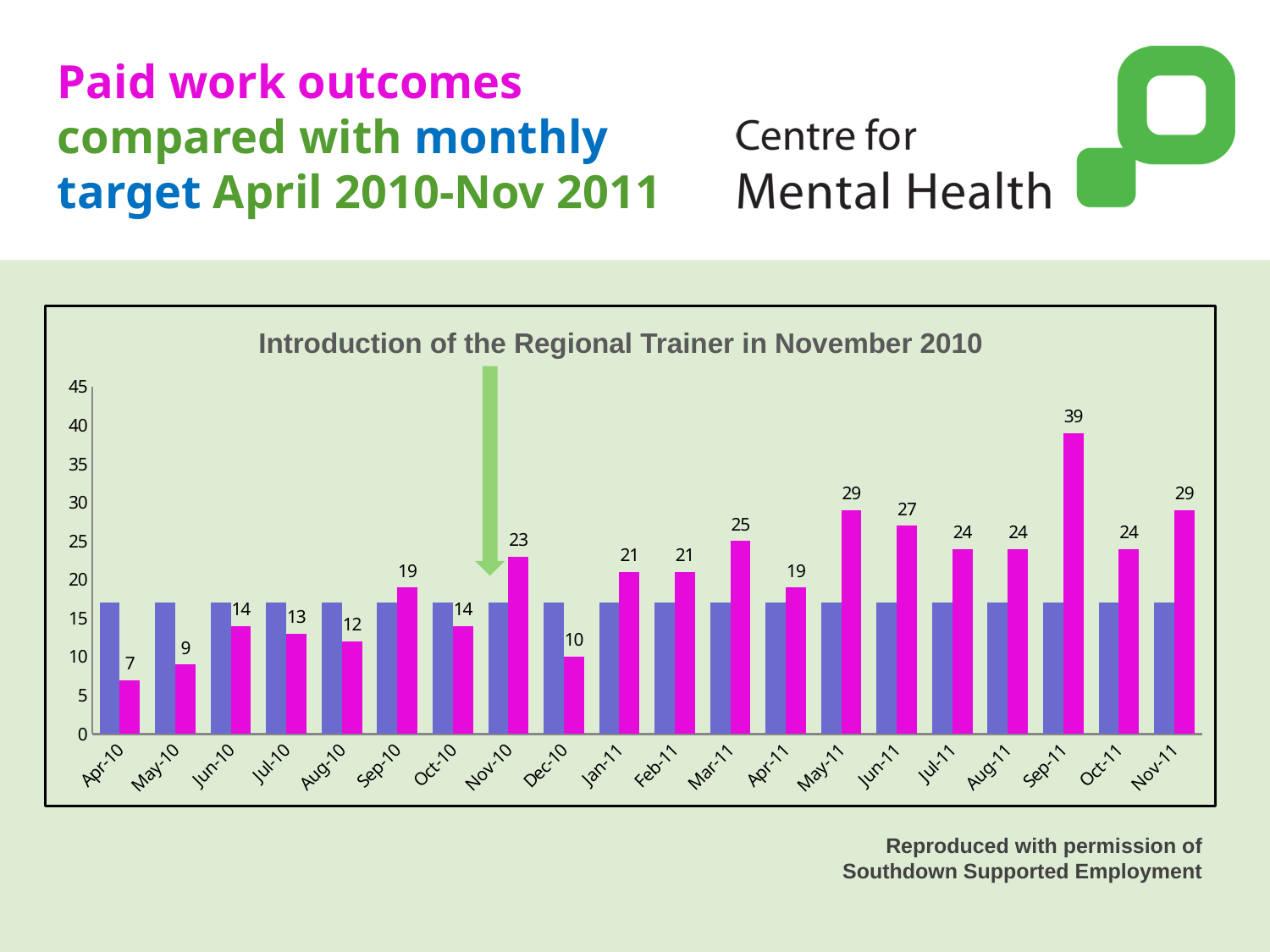
What is the difference between the labelled magenta values for Sep-11 and Nov-11? 10 What kind of chart is shown on the slide? Bar chart What is the labelled value of the magenta bar for Apr-10? 7 What is the labelled value of the magenta bar for Dec-10? 10 Do the labelled magenta values generally rise or fall from Apr-10 to Nov-11? Rise What is the labelled value of the magenta bar for Sep-11? 39 What event does the annotation above the chart say happened in November 2010? Introduction of the Regional Trainer Which month has the highest labelled magenta bar? Sep-11 Which month has the larger labelled magenta value, Nov-10 or Dec-10? Nov-10 Which month has the lowest labelled magenta bar? Apr-10 Is the value of the blue bar for Apr-10 greater or less than 15? greater How many months are shown on the x axis of the chart? 20